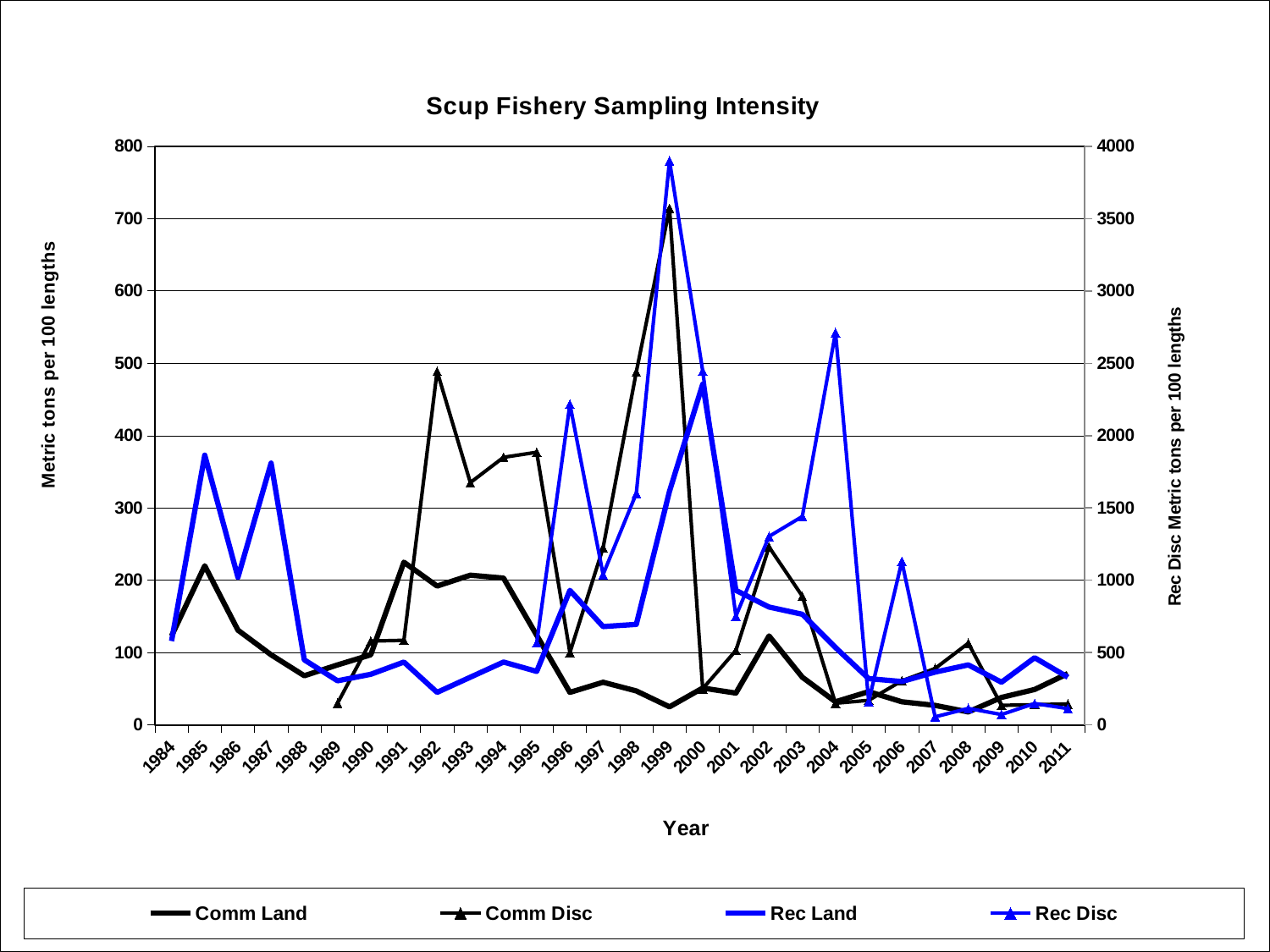
What is the title of the x axis? Year Is the Rec Disc value for 2004 greater or less than 2500 on the right axis? greater In 1987, which series has the larger value: Rec Land or Comm Land? Rec Land In which year does the Rec Land series reach its highest value? 2000 Is the Comm Disc value for 1992 greater or less than 400 on the left axis? greater Is the Comm Land value for 1999 greater or less than 100 on the left axis? less What kind of chart is shown on the slide? line chart In which year does the Rec Disc series reach its highest value? 1999 In which year does the Comm Disc series reach its highest value? 1999 How many series does the legend list? 4 How many years are plotted along the x axis? 28 Does the Comm Disc series rise or fall from 1999 to 2000? fall